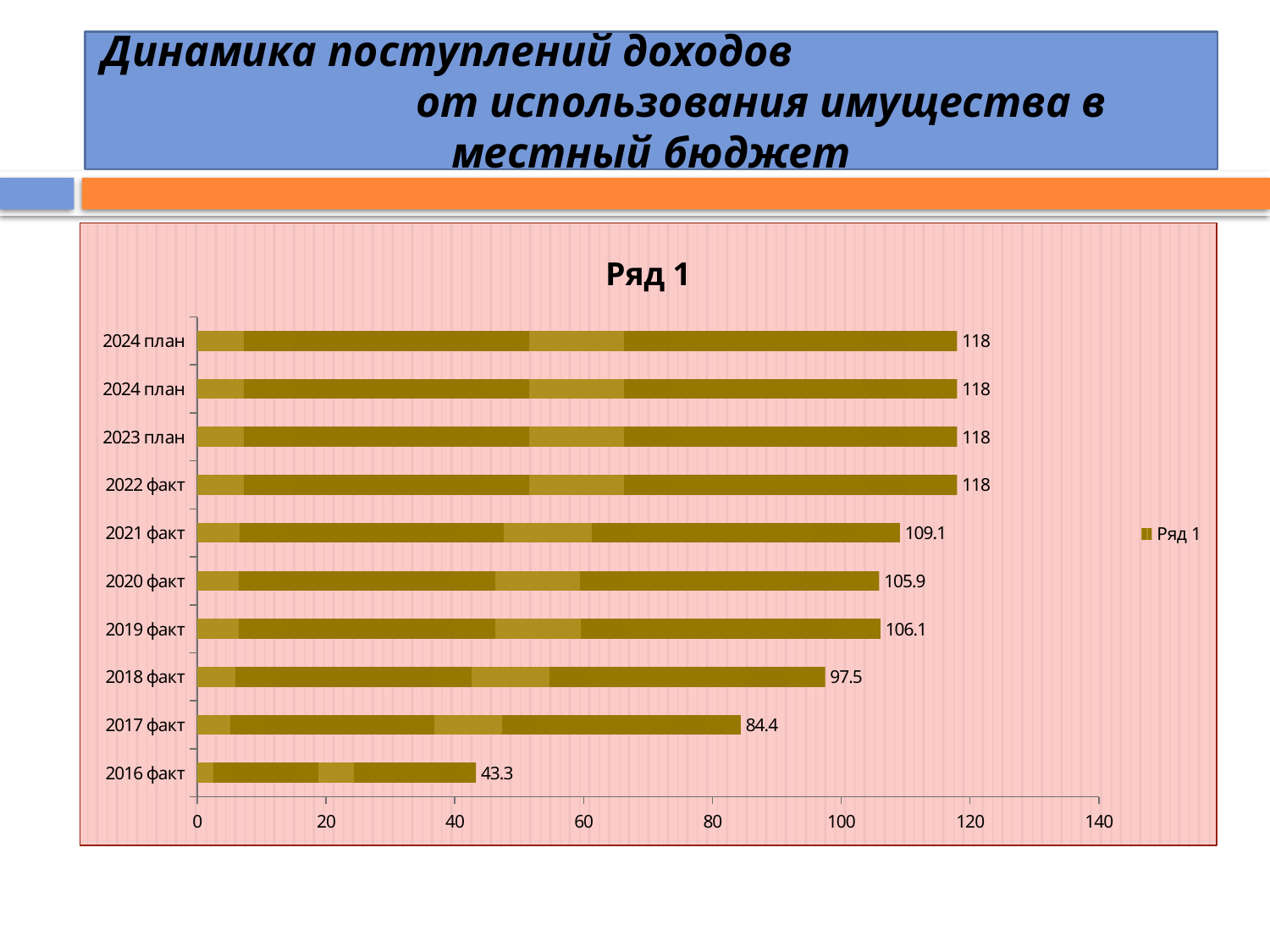
Which category has the lowest value? 2016 факт How many categories are shown on the chart? 10 What is the value for 2021 факт? 109.1 What is the difference between the values for 2022 факт and 2021 факт? 8.9 What is the value for 2018 факт? 97.5 What is the value for 2023 план? 118 Which is larger, the value for 2019 факт or the value for 2018 факт? 2019 факт What kind of chart is shown on the slide? bar chart How many series does the legend list? 1 What is the value for 2016 факт? 43.3 What is the difference between the values for 2017 факт and 2016 факт? 41.1 Is the value for 2020 факт greater or less than 100? greater